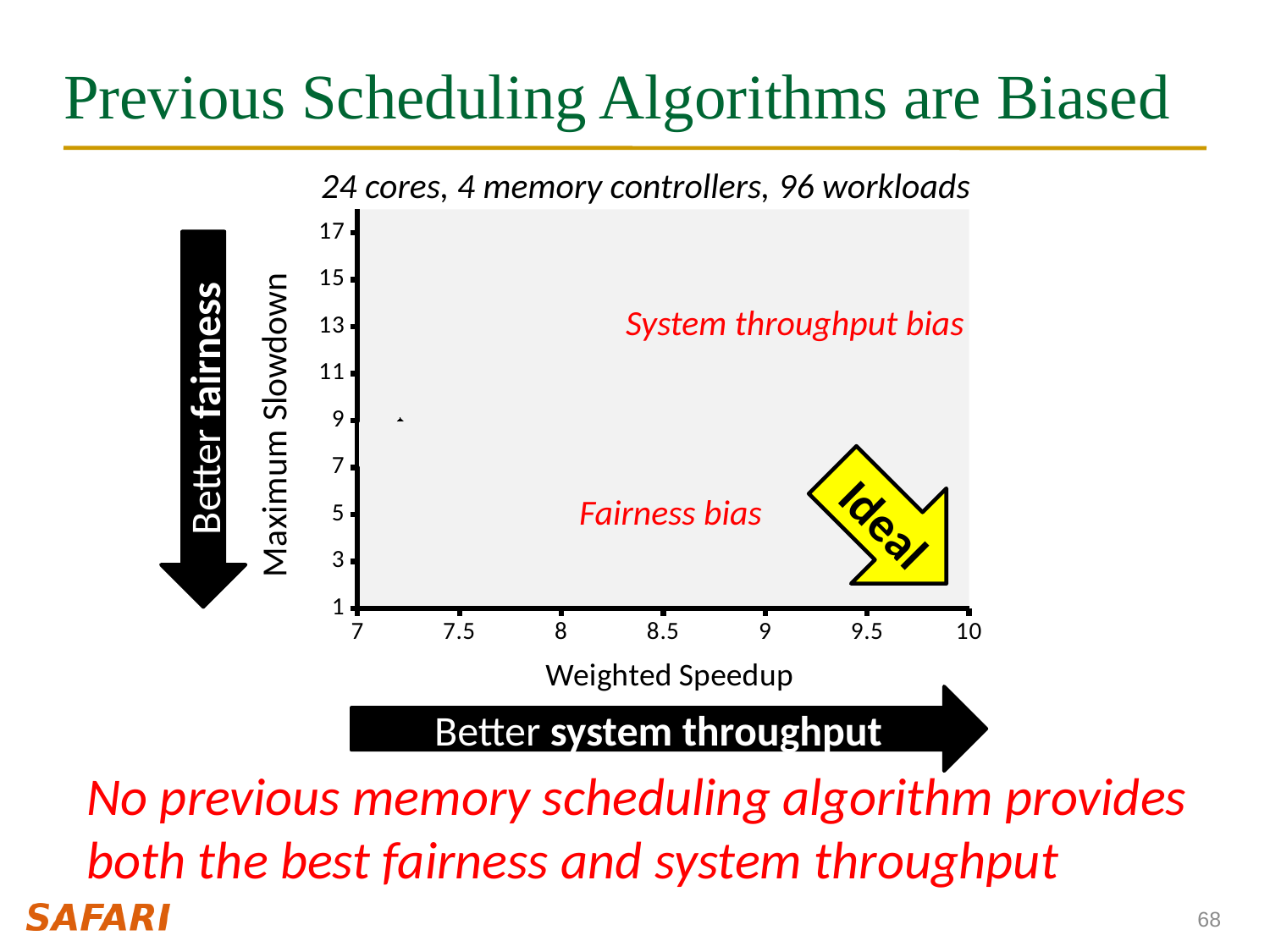
Is the Maximum Slowdown value of the plotted point greater or less than 11? less What is the highest tick value shown on the y axis of the chart? 17 What is the highest tick value shown on the x axis of the chart? 10 What kind of chart is shown on the slide? scatter chart Is the Maximum Slowdown value of the plotted point greater or less than 5? greater What is the label of the x axis of the chart? Weighted Speedup Is the Weighted Speedup value of the plotted point greater or less than 8? less How many data points are plotted on the chart? 1